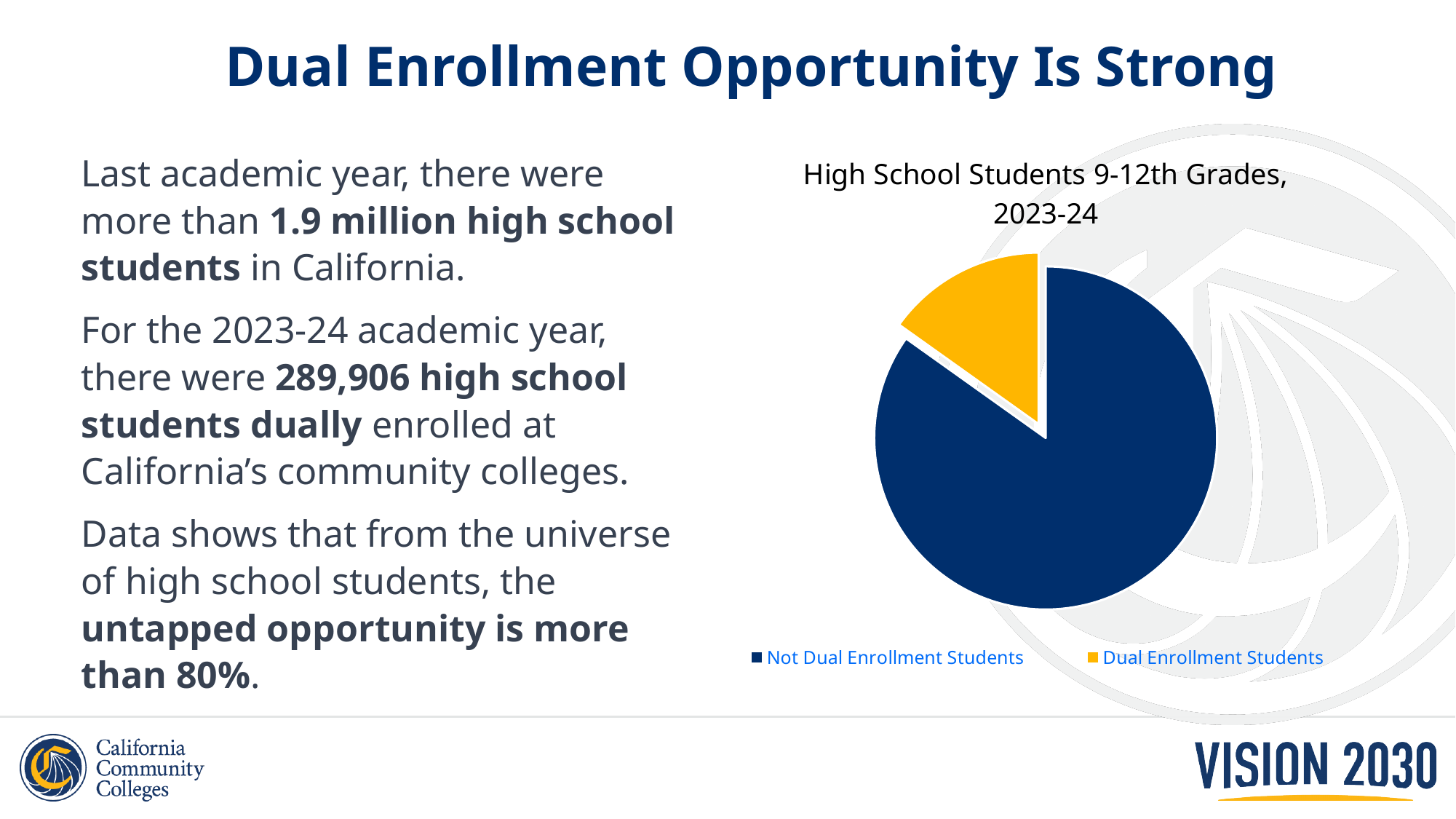
Which is larger in the pie chart: Not Dual Enrollment Students or Dual Enrollment Students? Not Dual Enrollment Students What is the title of the pie chart? High School Students 9-12th Grades, 2023-24 Which slice of the pie chart is the largest? Not Dual Enrollment Students How many entries does the pie chart's legend list? 2 Which slice of the pie chart is the smallest? Dual Enrollment Students What colour is the Dual Enrollment Students slice in the pie chart? gold How many slices does the pie chart have? 2 What kind of chart is shown on the slide? pie chart